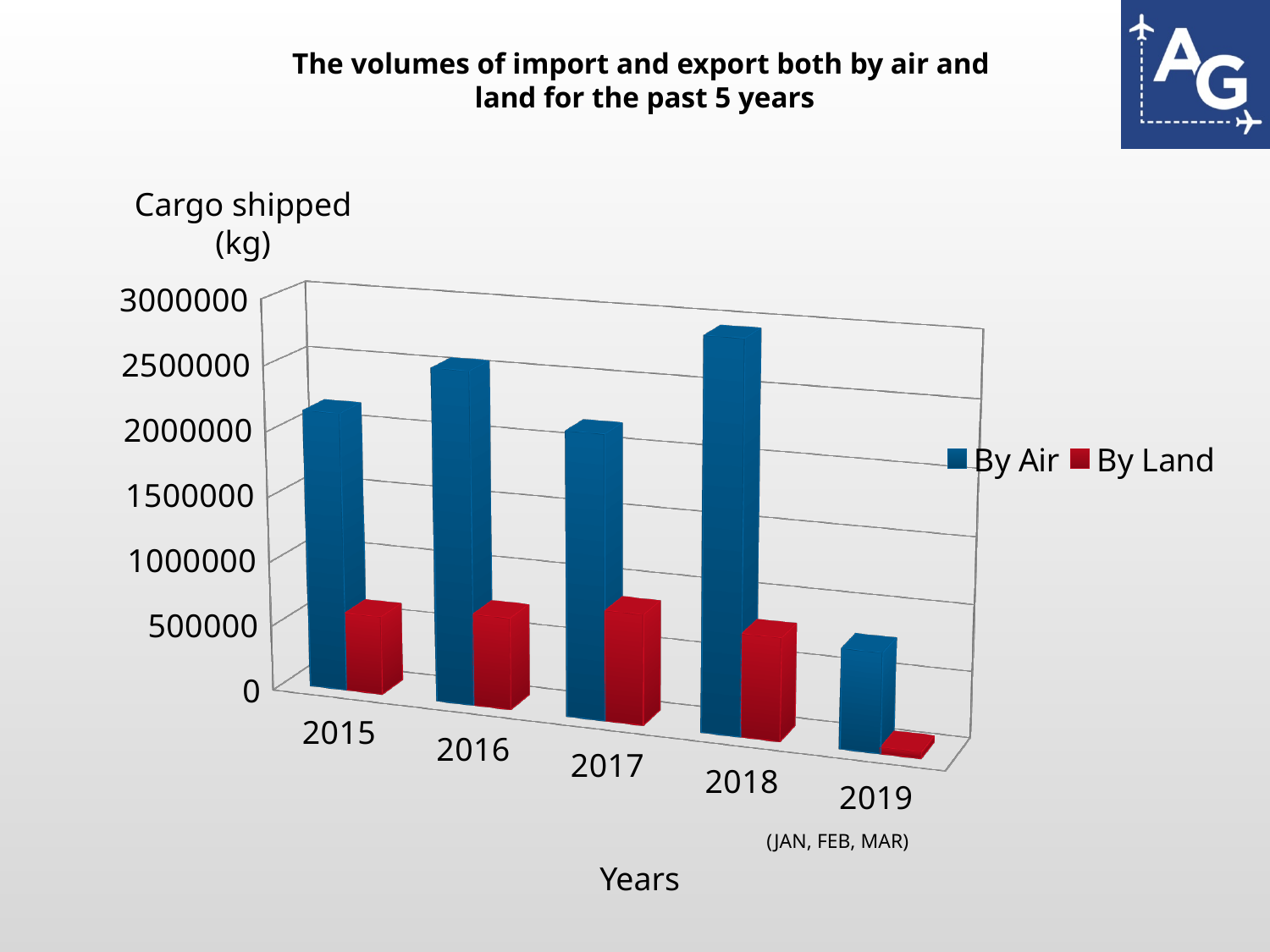
What kind of chart is shown on the slide? Bar chart How many years are shown on the x axis? 5 Is the By Land value for 2015 greater or less than 1000000? less Which year has the highest By Air value? 2018 What is the title of the vertical axis? Cargo shipped (kg) Does the By Air value rise or fall from 2018 to 2019? Fall Which year has the lowest By Land value? 2019 How many series does the legend list? 2 Which year has the lowest By Air value? 2019 Which is larger in 2015, the By Air value or the By Land value? By Air Is the By Air value for 2018 greater or less than 2000000? greater Is the By Air value for 2019 greater or less than 1000000? less